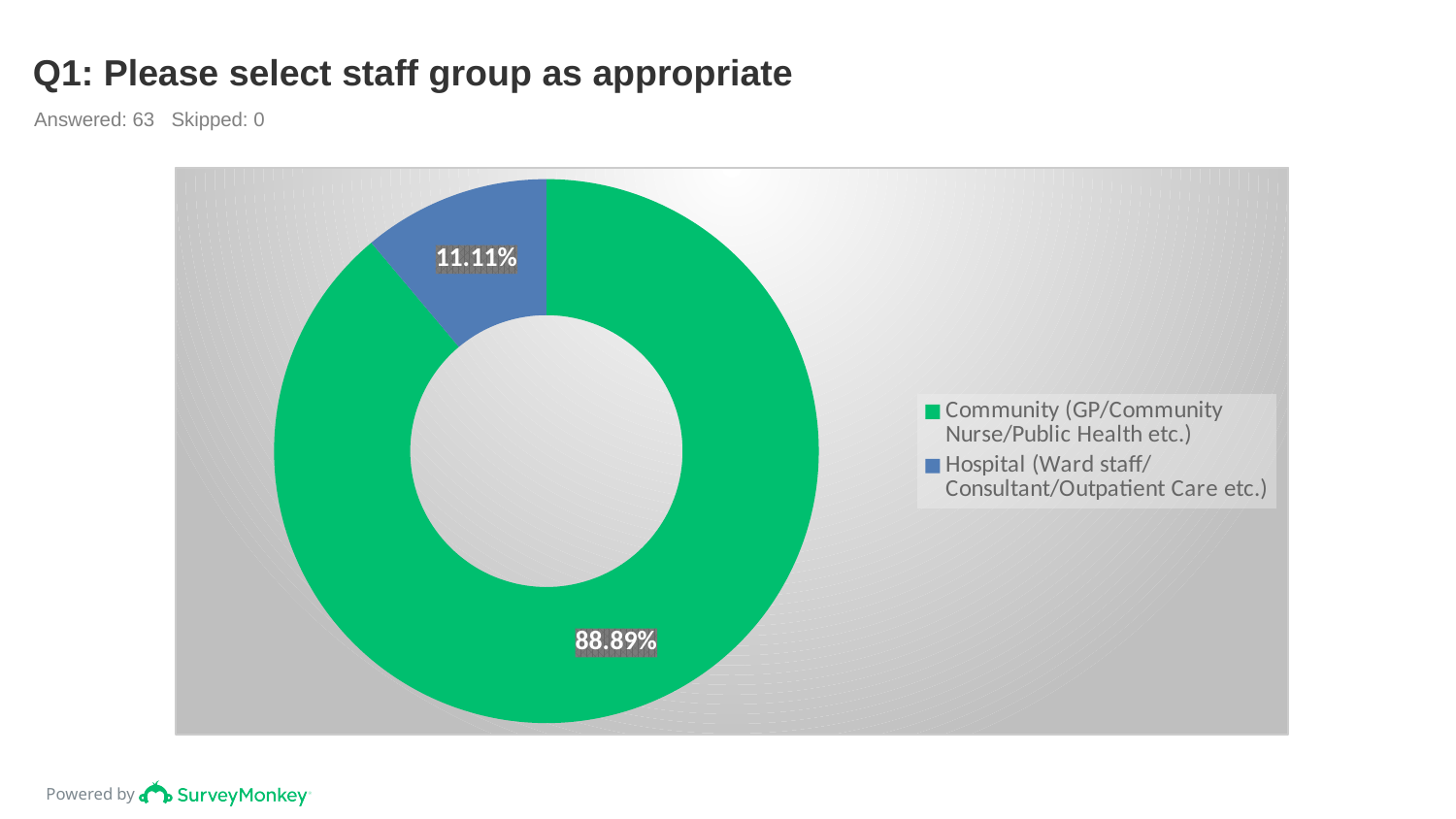
How many staff group categories are shown in the chart? 2 What is the title of the chart? Q1: Please select staff group as appropriate What share of the pie does the Hospital slice represent? 11.11% What colour is the Community (GP/Community Nurse/Public Health etc.) slice? Green What kind of chart is shown on the slide? Pie chart (doughnut) How many respondents answered this question? 63 Which staff group has the smallest share of the pie? Hospital (Ward staff/Consultant/Outpatient Care etc.) What is the difference in percentage points between the Community and Hospital shares? 77.78 Which is larger, the Community share or the Hospital share? Community Which staff group has the largest share of the pie? Community (GP/Community Nurse/Public Health etc.) What percentage of respondents selected Hospital (Ward staff/Consultant/Outpatient Care etc.)? 11.11% What percentage of respondents selected Community (GP/Community Nurse/Public Health etc.)? 88.89%